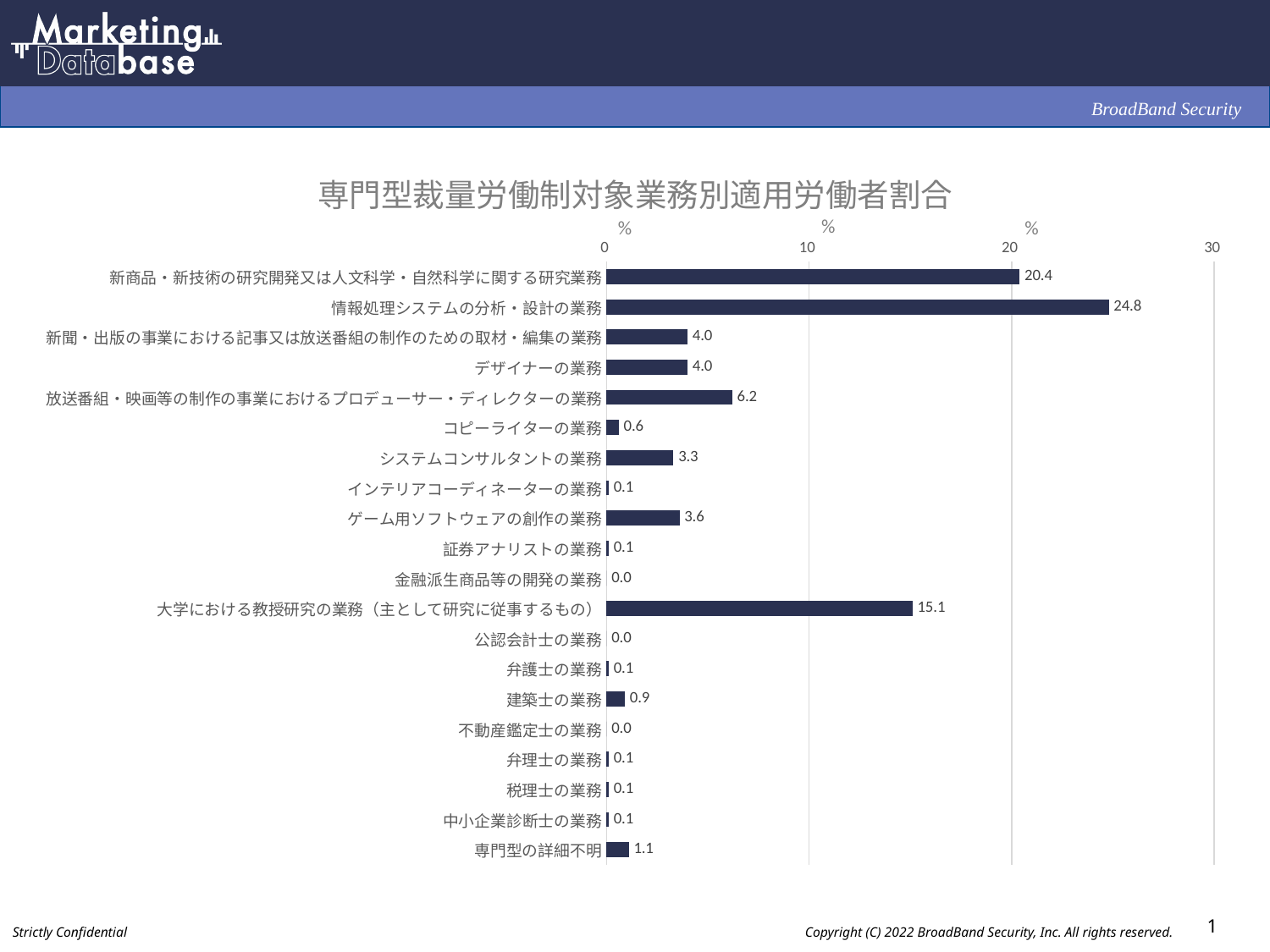
What is the difference between the values for 放送番組・映画等の制作の事業におけるプロデューサー・ディレクターの業務 and デザイナーの業務? 2.2 What is the value for システムコンサルタントの業務? 3.3 What type of chart is shown on the slide? Bar chart Is the value for 大学における教授研究の業務（主として研究に従事するもの） greater or less than 10? greater What is the title of the chart? 専門型裁量労働制対象業務別適用労働者割合 Which is larger, the value for ゲーム用ソフトウェアの創作の業務 or the value for システムコンサルタントの業務? ゲーム用ソフトウェアの創作の業務 Which category has the highest value? 情報処理システムの分析・設計の業務 What is the value for 情報処理システムの分析・設計の業務? 24.8 What is the difference between the values for 情報処理システムの分析・設計の業務 and 新商品・新技術の研究開発又は人文科学・自然科学に関する研究業務? 4.4 How many categories are shown in the chart? 20 What is the value for 専門型の詳細不明? 1.1 What is the value for 大学における教授研究の業務（主として研究に従事するもの）? 15.1